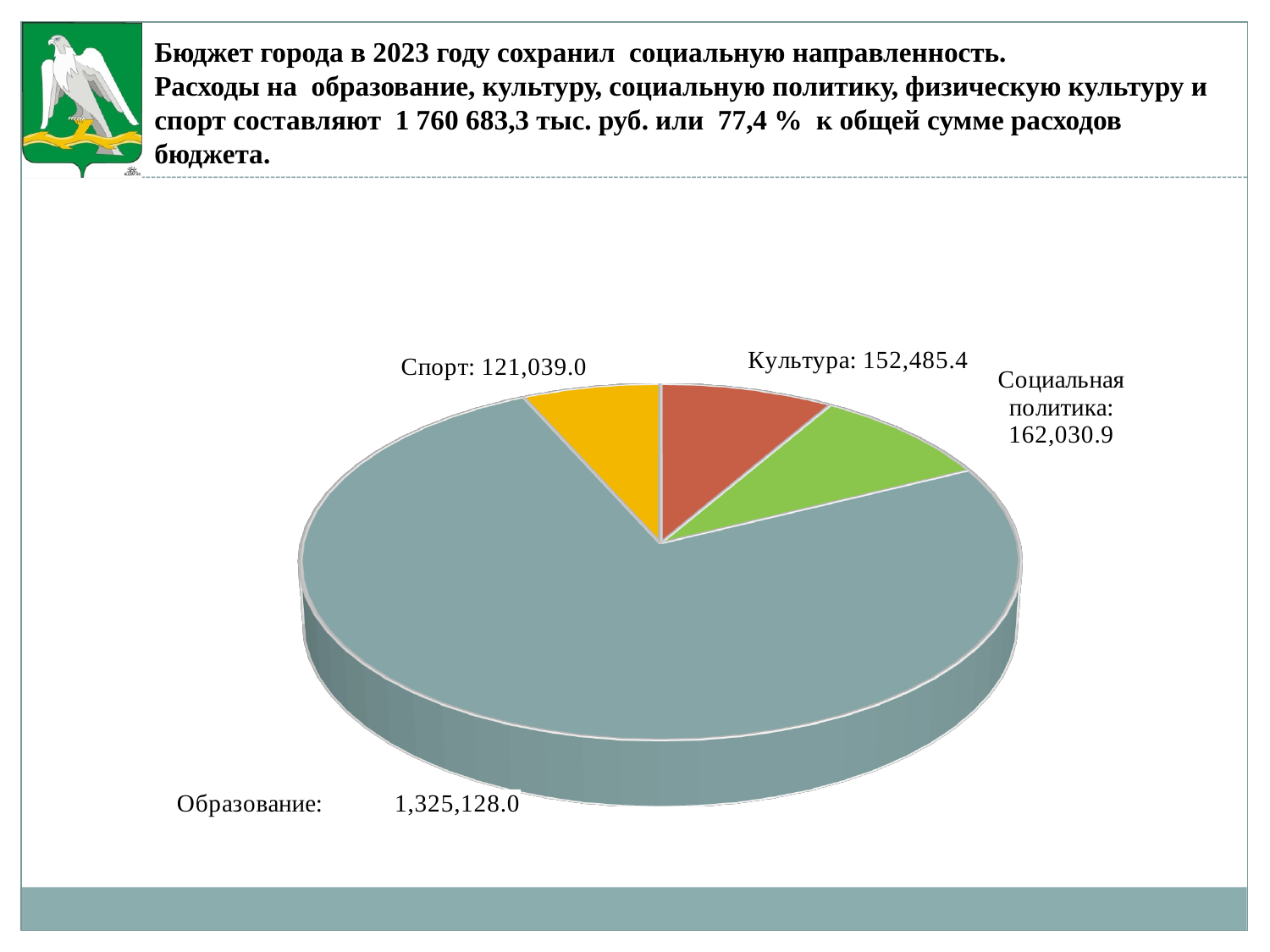
What is the value for Спорт in the pie chart? 121,039.0 Which category has the largest slice in the pie chart? Образование What is the value for Культура in the pie chart? 152,485.4 What is the difference between the values for Культура and Спорт? 31,446.4 Which is larger, the value for Культура or the value for Социальная политика? Социальная политика How many slices does the pie chart have? 4 What is the difference between the values for Социальная политика and Культура? 9,545.5 What is the value for Социальная политика in the pie chart? 162,030.9 Which category has the smallest slice in the pie chart? Спорт What is the value for Образование in the pie chart? 1,325,128.0 What colour is the Спорт slice in the pie chart? Yellow What kind of chart is shown on the slide? Pie chart